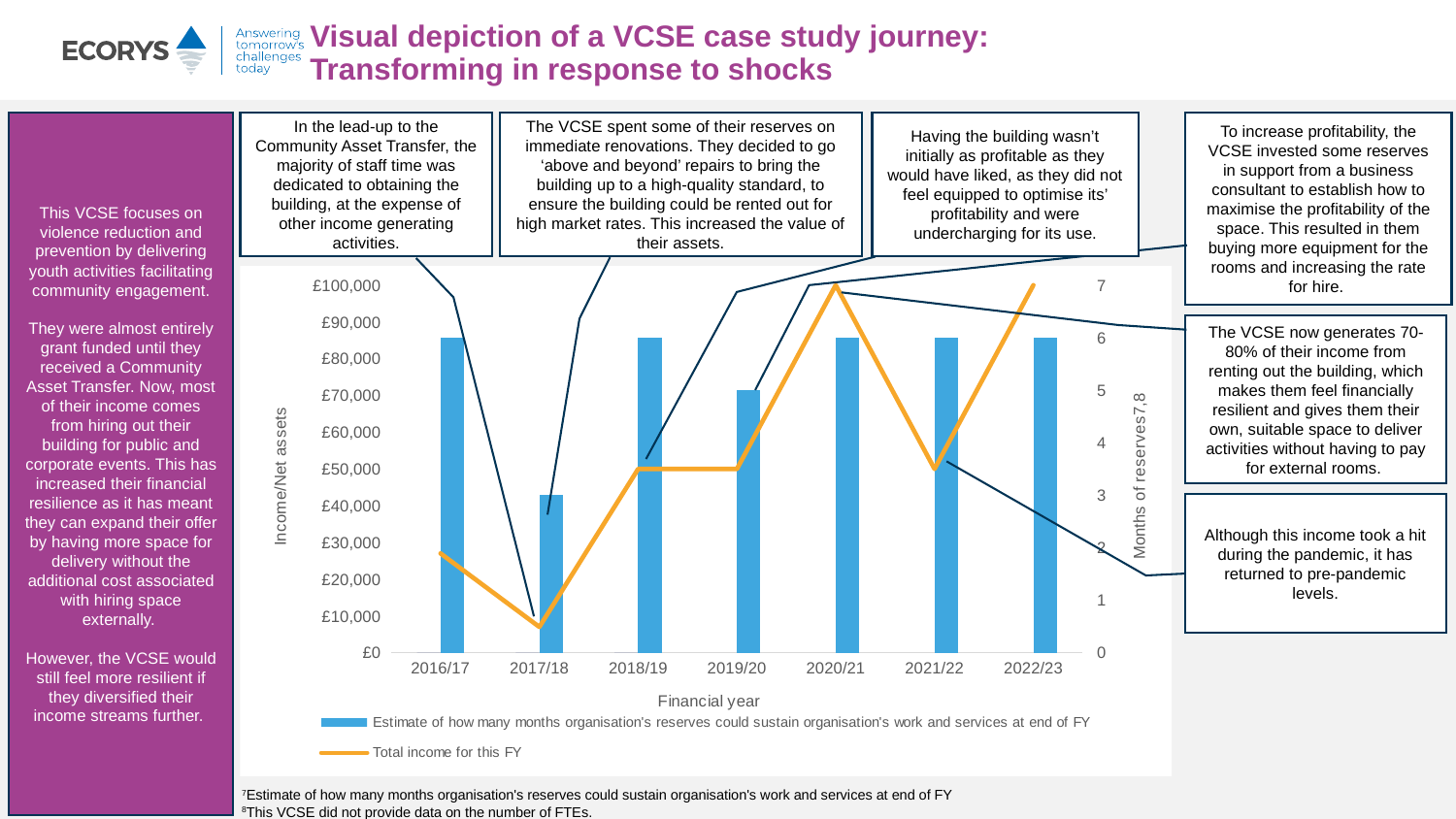
What is the total income for 2020/21 shown by the line? £100,000 Is the months of reserves value for 2016/17 greater or less than 5? greater How many series does the chart's legend list? 2 How many months of reserves does the bar for 2017/18 show? 3 What is the title of the chart's x axis? Financial year In which financial year is the estimate of months of reserves (the bars) lowest? 2017/18 Is the total income for 2017/18 greater or less than £20,000? less Which financial year has the higher months of reserves bar, 2017/18 or 2019/20? 2019/20 How many financial years are shown on the x axis of the chart? 7 Does the total income line rise or fall from 2016/17 to 2017/18? fall What kind of chart is shown on the slide? A combined bar and line chart Is the total income for 2020/21 greater or less than £90,000? greater